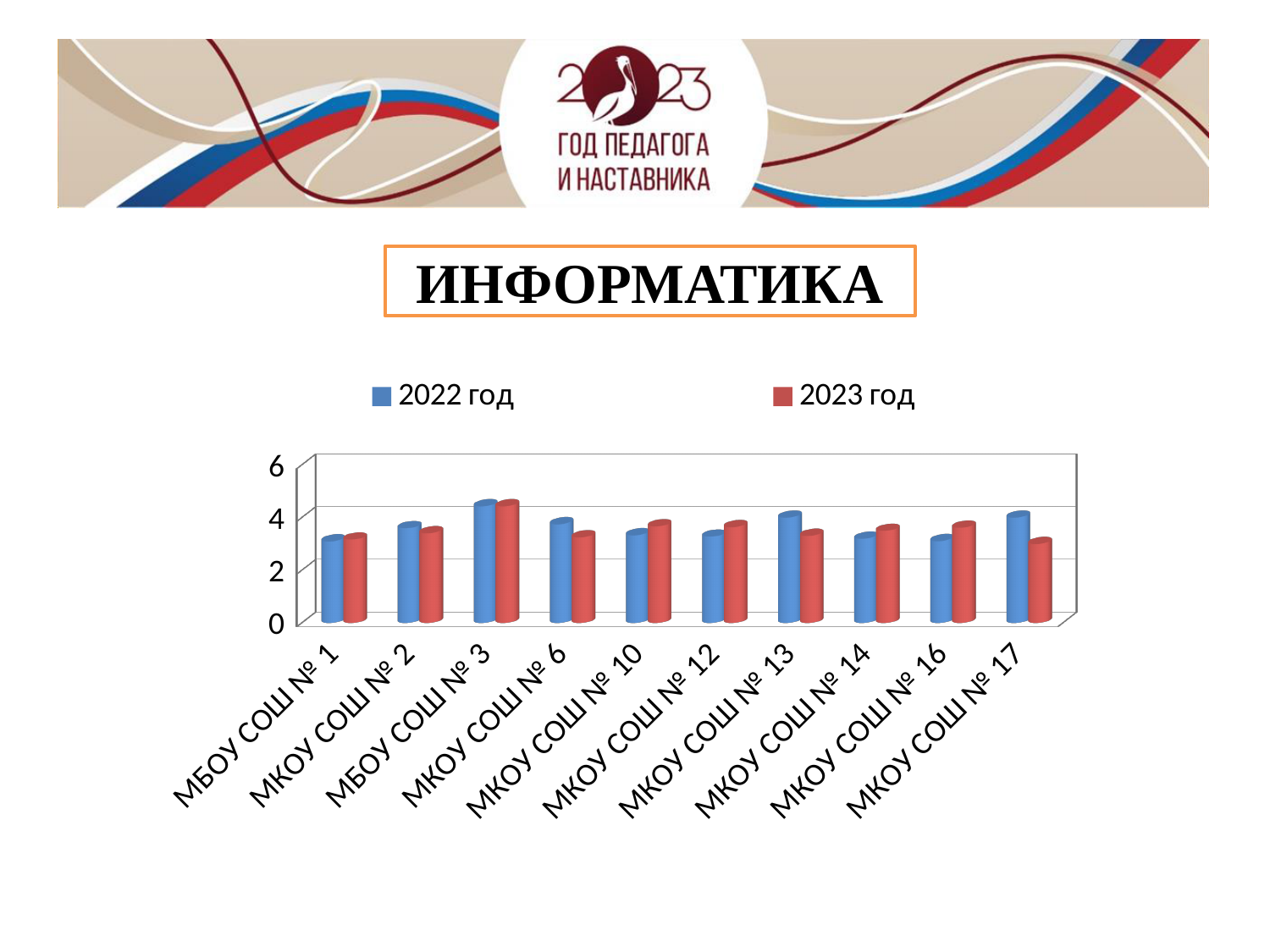
Which school has the highest value for 2023 год? МБОУ СОШ № 3 Which colour represents the 2023 год series in the legend? red For МКОУ СОШ № 6, which is larger: the 2022 год value or the 2023 год value? 2022 год Which school has the highest value for 2022 год? МБОУ СОШ № 3 For МКОУ СОШ № 16, which is larger: the 2022 год value or the 2023 год value? 2023 год How many series does the legend list? 2 How many schools (categories) are shown on the x axis? 10 What kind of chart is shown on the slide? bar chart Is the 2022 год value for МКОУ СОШ № 13 greater or less than 2? greater For МКОУ СОШ № 17, which is larger: the 2022 год value or the 2023 год value? 2022 год Is the 2023 год value for МБОУ СОШ № 3 greater or less than 6? less What subject is named in the title above the chart? ИНФОРМАТИКА